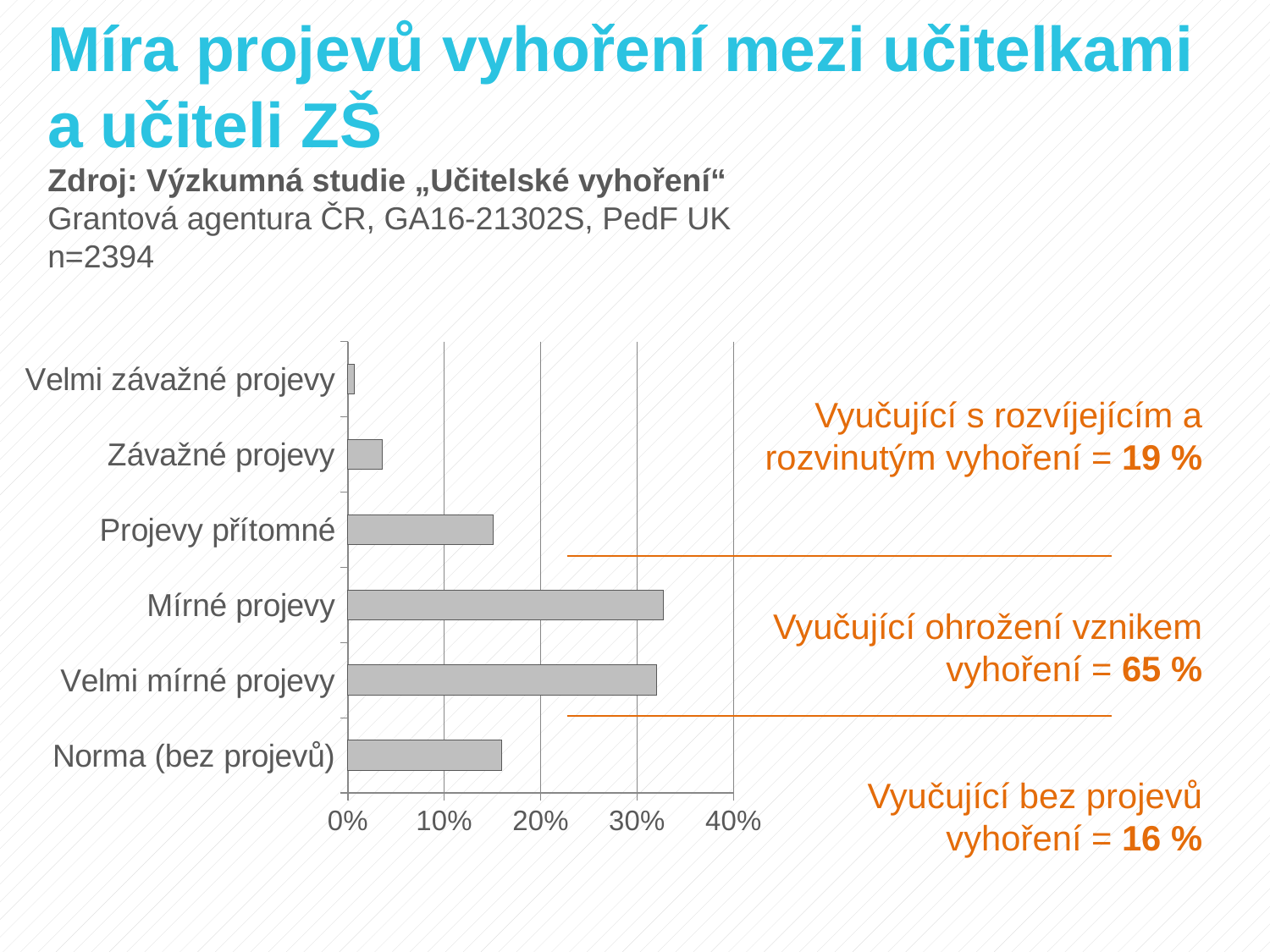
What kind of chart is shown on the slide? bar chart Is the value for Velmi mírné projevy greater or less than 20%? greater Which category has the lowest value on the chart? Velmi závažné projevy What is the highest value shown on the horizontal axis of the chart? 40% Is the value for Závažné projevy greater or less than 10%? less Which is larger, the value for Projevy přítomné or the value for Závažné projevy? Projevy přítomné Is the value for Projevy přítomné greater or less than 20%? less Which is larger, the value for Mírné projevy or the value for Norma (bez projevů)? Mírné projevy How many categories are shown on the chart? 6 According to the annotation next to the chart, what share of teachers is at risk of developing burnout (Vyučující ohrožení vznikem vyhoření)? 65 %